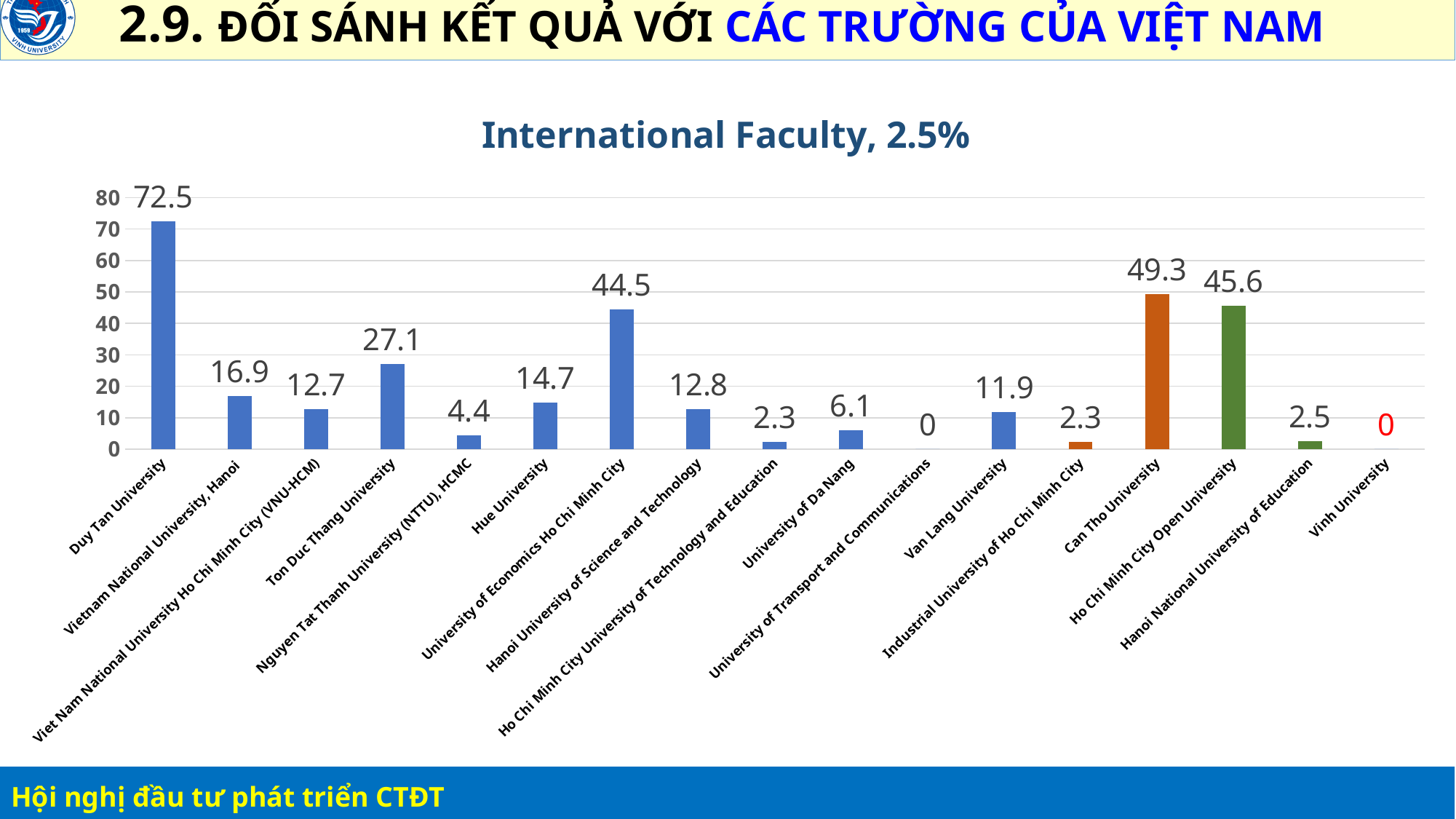
What is the title of the chart? International Faculty, 2.5% What is the difference between the values for Duy Tan University and Can Tho University? 23.2 Is the value for Duy Tan University greater or less than 70? greater Which university has the highest value? Duy Tan University What is the value for Vinh University? 0 What is the value for Duy Tan University? 72.5 How many universities are shown on the chart? 17 What kind of chart is shown on the slide? bar chart Which is larger, the value for Hue University or the value for Hanoi University of Science and Technology? Hue University What is the difference between the values for Can Tho University and Ho Chi Minh City Open University? 3.7 What is the value for Can Tho University? 49.3 What is the value for University of Economics Ho Chi Minh City? 44.5